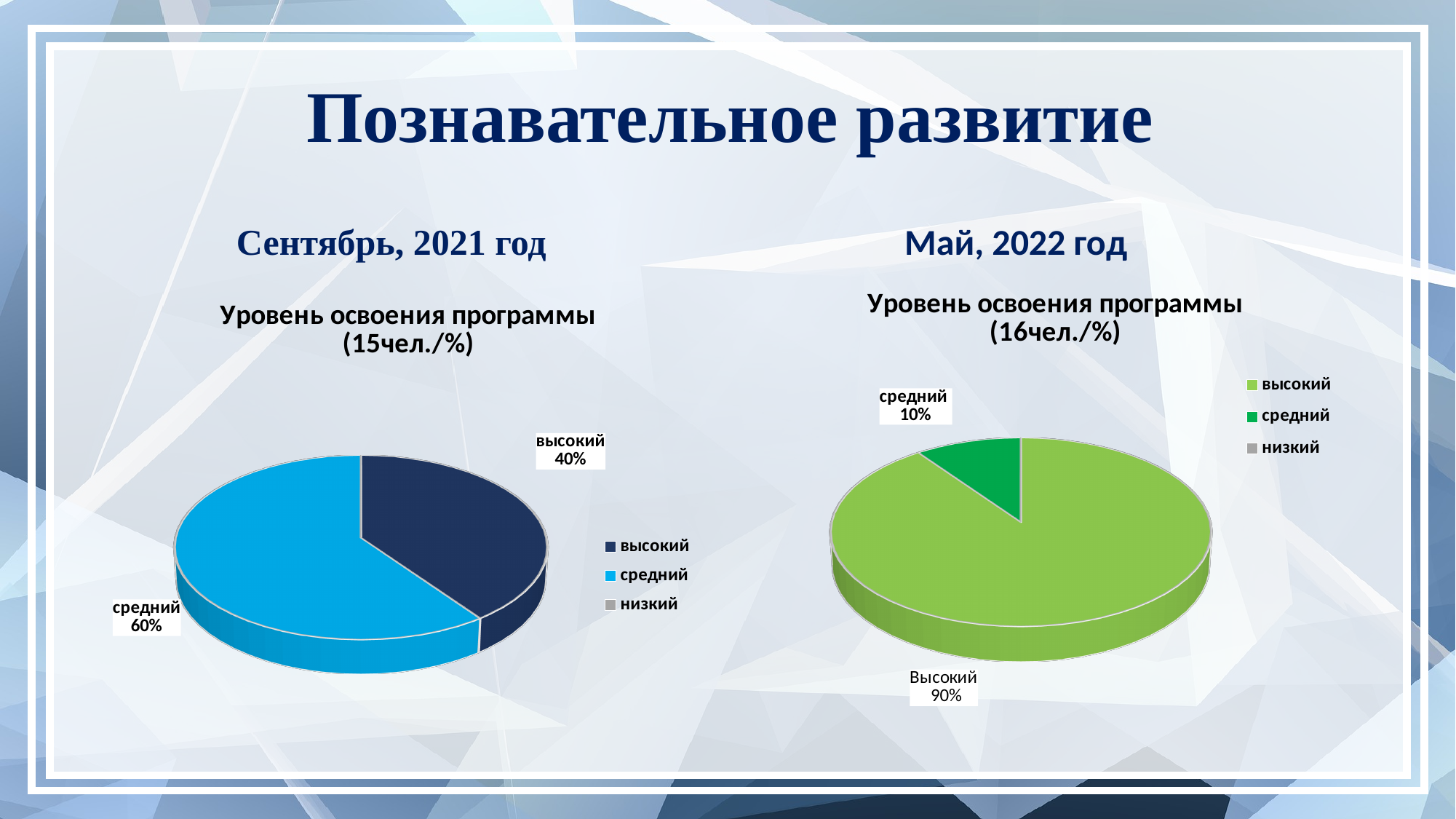
In the "Сентябрь, 2021 год" chart, what is the value for "высокий"? 40% Which is larger: "высокий" in the "Сентябрь, 2021 год" chart or "Высокий" in the "Май, 2022 год" chart? Высокий in Май, 2022 год What kind of chart is shown under "Сентябрь, 2021 год"? pie chart In the "Май, 2022 год" chart, which category has the largest slice? Высокий How many entries does the legend of the "Май, 2022 год" chart list? 3 In the "Сентябрь, 2021 год" chart, what is the value for "средний"? 60% In the "Май, 2022 год" chart, what is the difference between "Высокий" and "средний"? 80% What is the title of the chart under "Сентябрь, 2021 год"? Уровень освоения программы (15чел./%) In the "Май, 2022 год" chart, what is the value for "Высокий"? 90% In the "Сентябрь, 2021 год" chart, which category has the largest slice? средний In the "Май, 2022 год" chart, what is the value for "средний"? 10% In the "Сентябрь, 2021 год" chart, what is the difference between "средний" and "высокий"? 20%